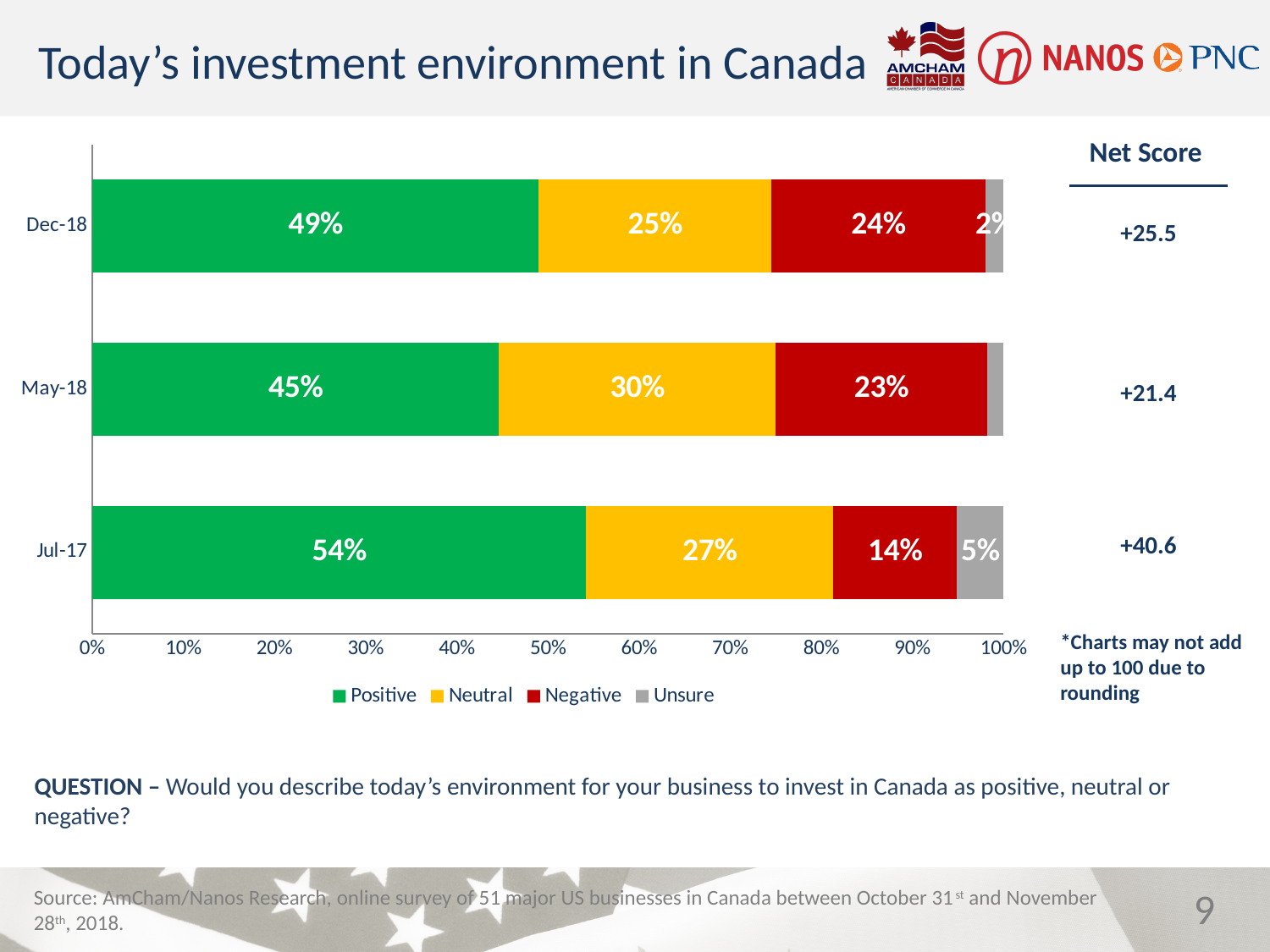
How many time periods (categories) are plotted on the chart? 3 Is the Negative value for Dec-18 larger or smaller than the Negative value for May-18? Larger What is the Unsure value for Jul-17? 5% What is the difference between the Positive values for Dec-18 and May-18? 4% How many series does the legend list? 4 Which legend entry is shown in green? Positive Which period has the highest Positive value? Jul-17 What is the Negative value for Jul-17? 14% What is the Positive value for Dec-18? 49% Which period has the lowest Negative value? Jul-17 What is the Neutral value for May-18? 30% What type of chart is shown on the slide? Stacked bar chart